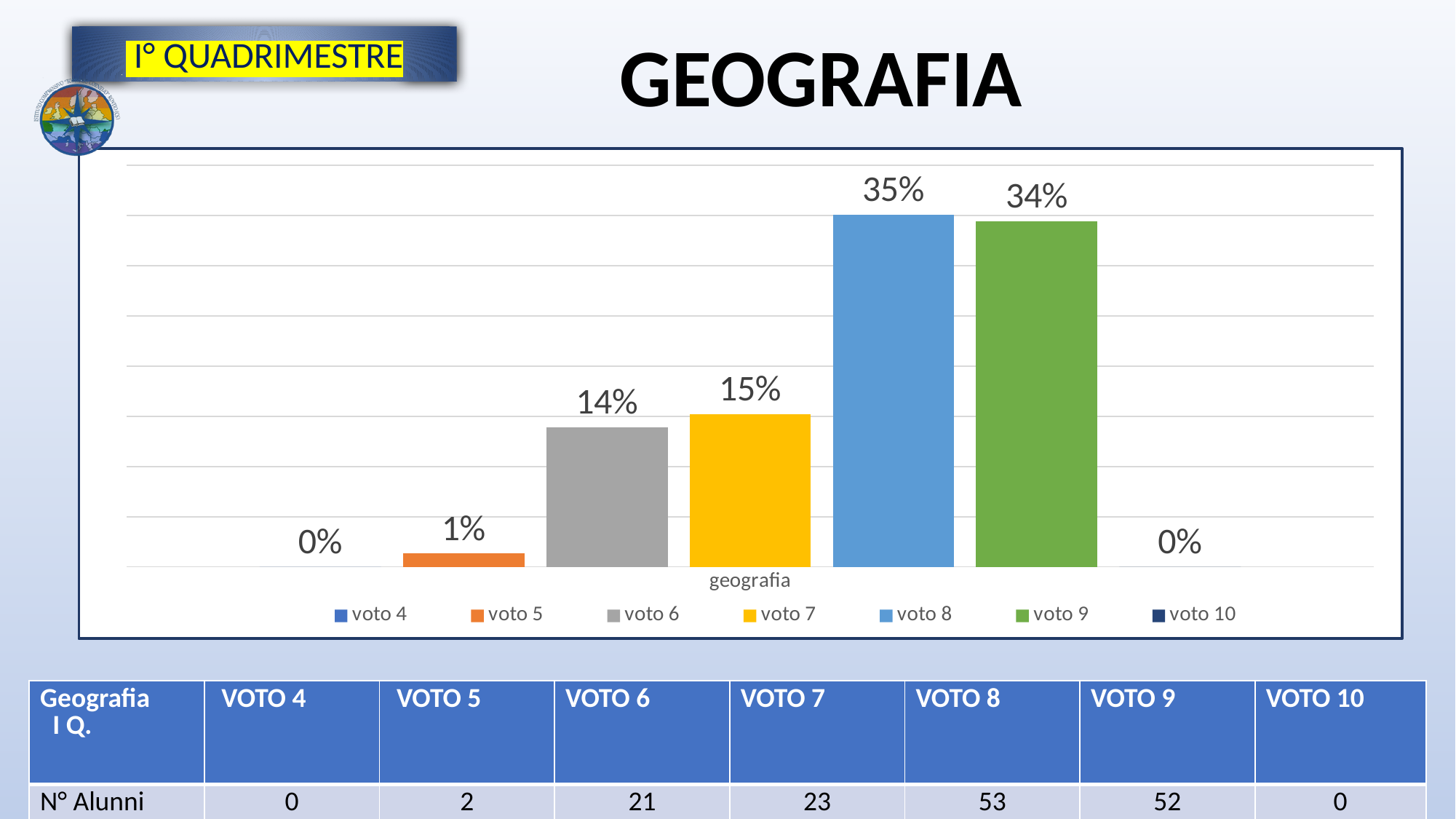
What percentage is shown for voto 8? 35% What colour is the bar for voto 7? yellow How many series does the legend list? 7 What is the difference in percentage points between voto 8 and voto 7? 20 What percentage is shown for voto 6? 14% What percentage is shown for voto 5? 1% Which series has the highest percentage? voto 8 What is the combined percentage for voto 8 and voto 9? 69% What is the difference in percentage points between voto 7 and voto 6? 1 What is the category label shown on the x axis? geografia Which is larger, the value for voto 9 or the value for voto 6? voto 9 What kind of chart is shown? bar chart